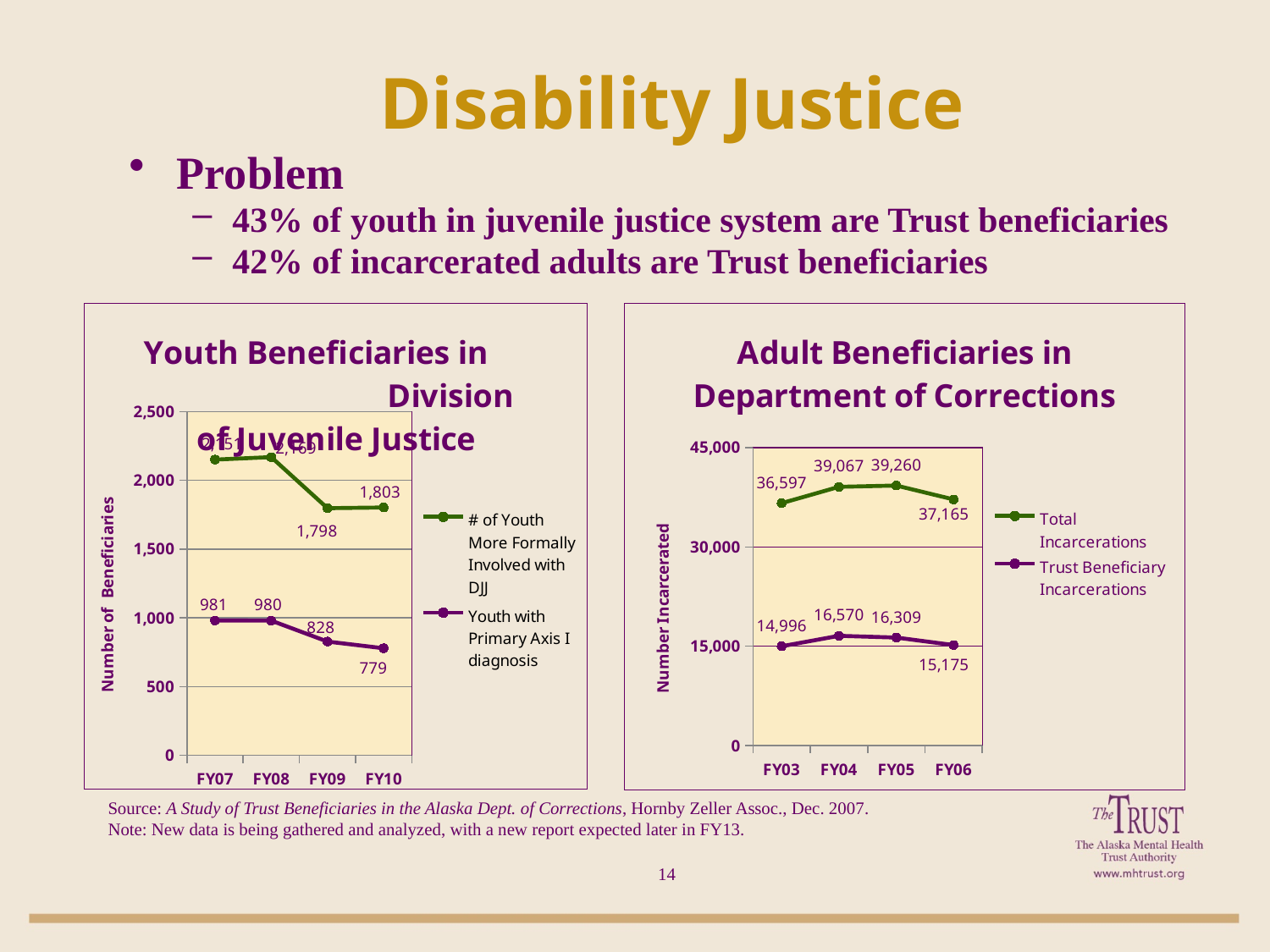
In the Youth Beneficiaries in Division of Juvenile Justice chart, what is the value for Youth with Primary Axis I diagnosis in FY10? 779 In the Youth Beneficiaries in Division of Juvenile Justice chart, does the Youth with Primary Axis I diagnosis series rise or fall from FY07 to FY10? fall In the Adult Beneficiaries in Department of Corrections chart, what is the value for Trust Beneficiary Incarcerations in FY03? 14,996 In the Adult Beneficiaries in Department of Corrections chart, which fiscal year has the lowest Total Incarcerations? FY03 In the Youth Beneficiaries in Division of Juvenile Justice chart, what is the value for # of Youth More Formally Involved with DJJ in FY09? 1,798 In the Adult Beneficiaries in Department of Corrections chart, which fiscal year has the highest Trust Beneficiary Incarcerations? FY04 In the Youth Beneficiaries in Division of Juvenile Justice chart, how many fiscal years are shown on the x axis? 4 What kind of chart is the Adult Beneficiaries in Department of Corrections chart? line chart In the Adult Beneficiaries in Department of Corrections chart, how many series does the legend list? 2 In the Adult Beneficiaries in Department of Corrections chart, what is the difference between Total Incarcerations and Trust Beneficiary Incarcerations in FY06? 21,990 In the Youth Beneficiaries in Division of Juvenile Justice chart, what is the difference between the Youth with Primary Axis I diagnosis values for FY07 and FY10? 202 In the Adult Beneficiaries in Department of Corrections chart, what is the value for Total Incarcerations in FY05? 39,260